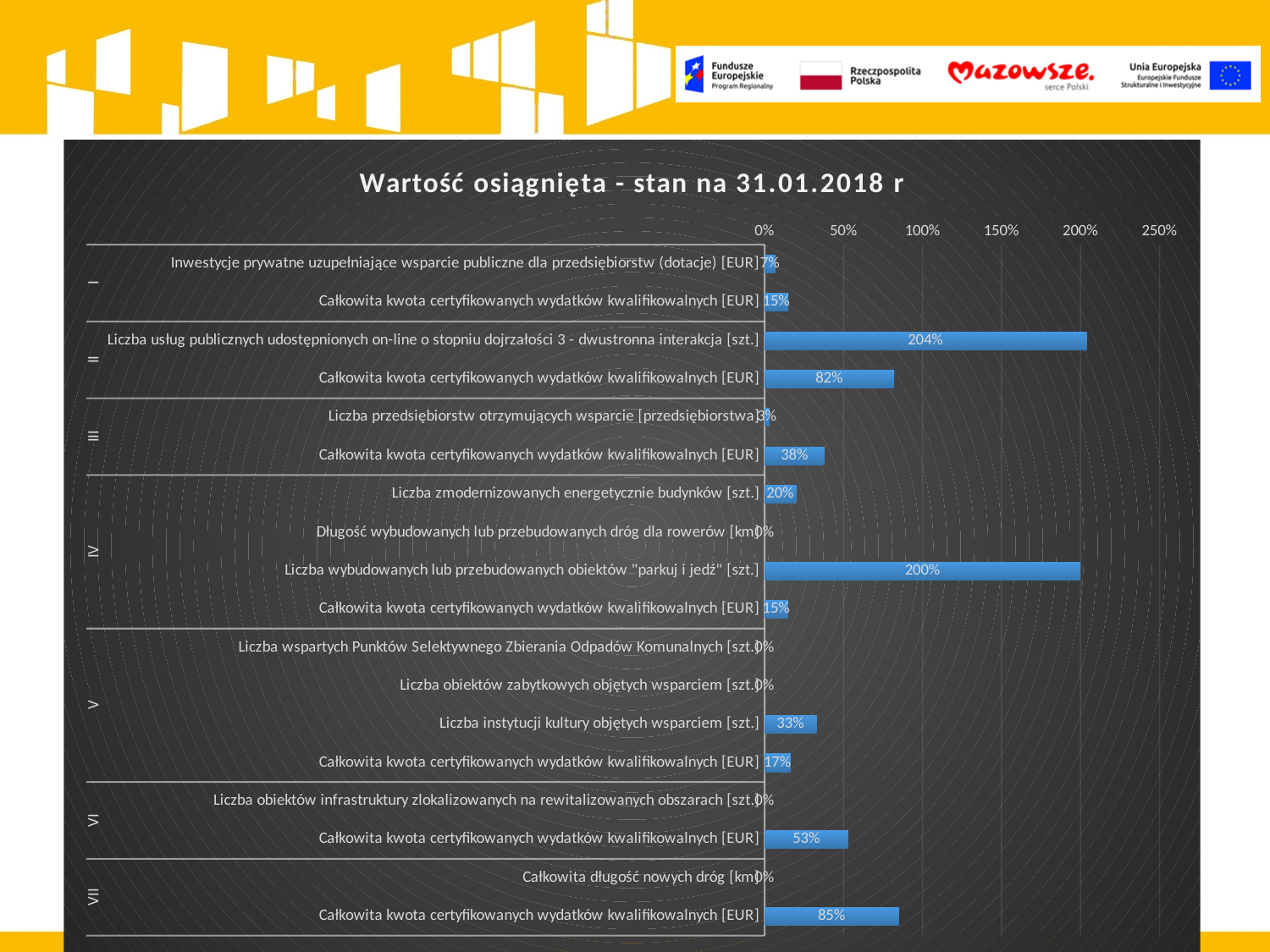
What is the title of the chart? Wartość osiągnięta - stan na 31.01.2018 r What is the difference between the value for "Całkowita kwota certyfikowanych wydatków kwalifikowalnych [EUR]" in group II and the value for "Liczba przedsiębiorstw otrzymujących wsparcie [przedsiębiorstwa]"? 79% How many bars (categories) are plotted in the chart? 18 What is the value for "Całkowita kwota certyfikowanych wydatków kwalifikowalnych [EUR]" in group VII? 85% What is the value for "Liczba usług publicznych udostępnionych on-line o stopniu dojrzałości 3 - dwustronna interakcja [szt.]"? 204% Which is larger: the value for "Całkowita kwota certyfikowanych wydatków kwalifikowalnych [EUR]" in group VI or the value for "Całkowita kwota certyfikowanych wydatków kwalifikowalnych [EUR]" in group III? Całkowita kwota certyfikowanych wydatków kwalifikowalnych [EUR] in group VI Which category has the highest value? Liczba usług publicznych udostępnionych on-line o stopniu dojrzałości 3 - dwustronna interakcja [szt.] What is the value for "Liczba zmodernizowanych energetycznie budynków [szt.]"? 20% What is the value for "Liczba wybudowanych lub przebudowanych obiektów "parkuj i jedź" [szt.]"? 200% Is the value for "Całkowita kwota certyfikowanych wydatków kwalifikowalnych [EUR]" in group II greater or less than 100%? less What is the value for "Liczba instytucji kultury objętych wsparciem [szt.]"? 33% What type of chart is shown on the slide? bar chart